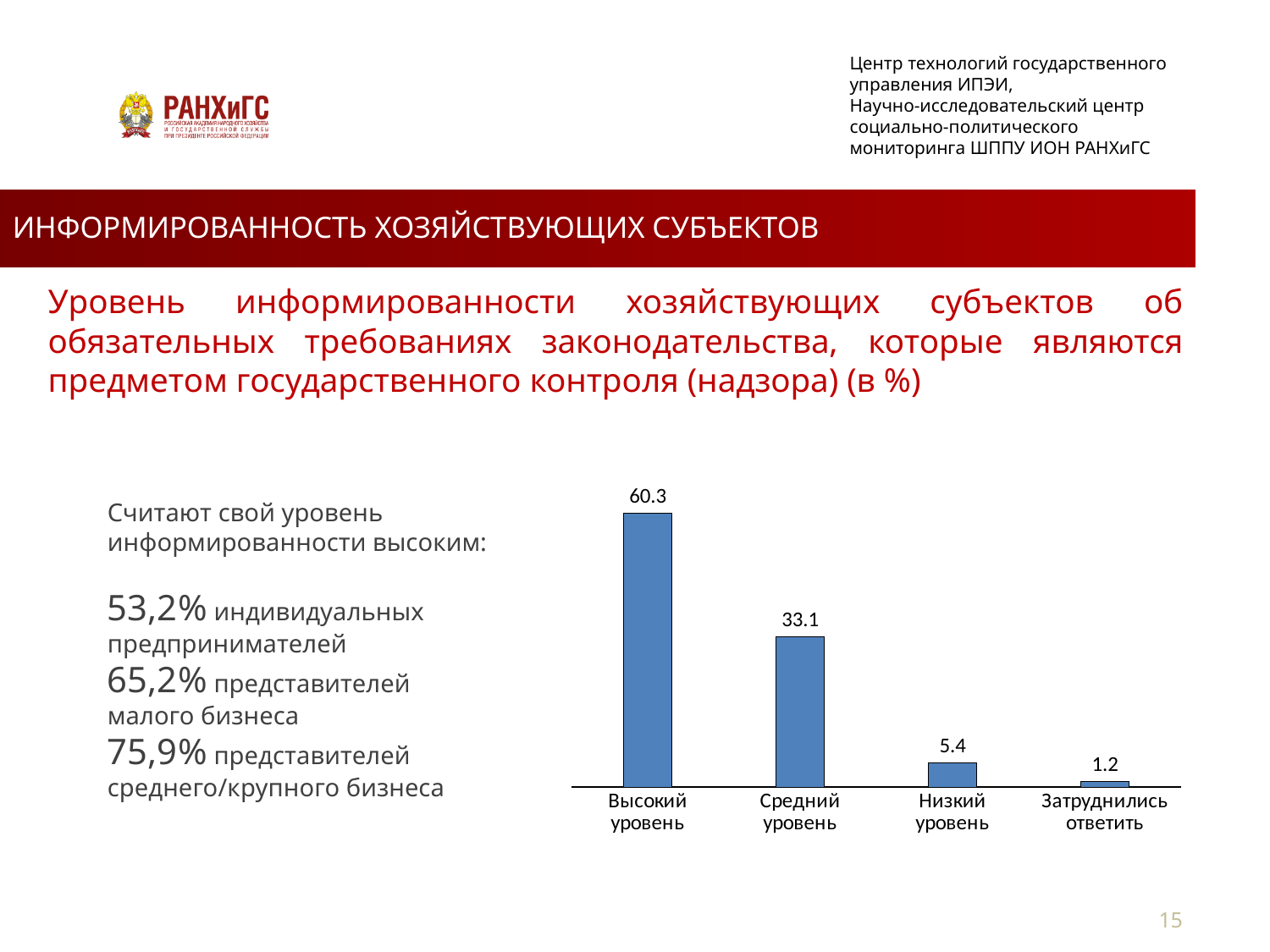
What is the value for Низкий уровень? 5.4 Which is larger, the value for Средний уровень or the value for Низкий уровень? Средний уровень What is the value for Затруднились ответить? 1.2 Do the values rise or fall from left to right along the x axis? Fall What kind of chart is shown on the slide? Bar chart What is the difference between the values for Низкий уровень and Затруднились ответить? 4.2 Which category has the highest value? Высокий уровень Which category has the lowest value? Затруднились ответить What is the value for Средний уровень? 33.1 What is the difference between the values for Высокий уровень and Средний уровень? 27.2 How many categories are shown in the chart? 4 What is the value for Высокий уровень? 60.3